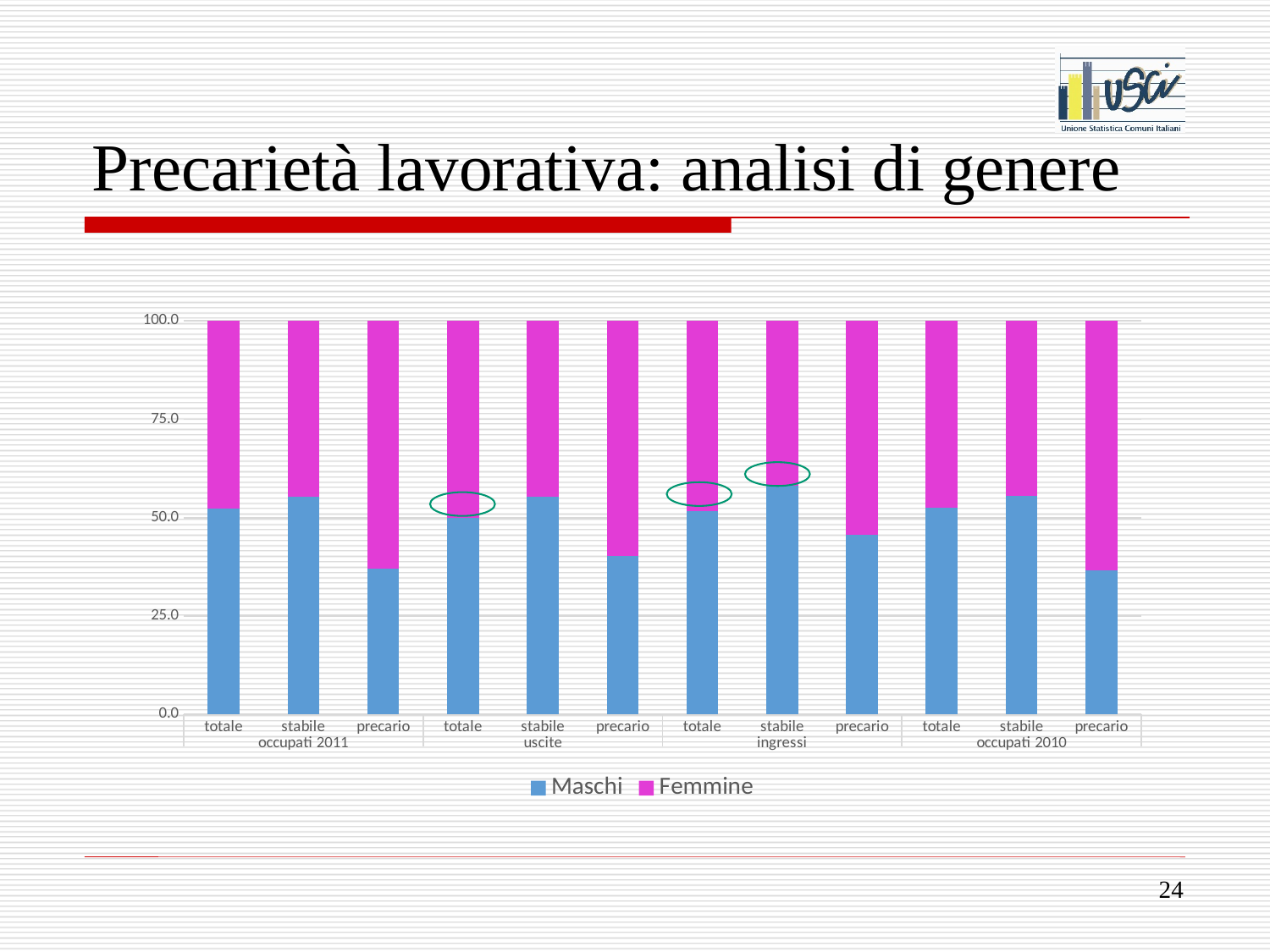
What kind of chart is shown on the slide? Stacked bar chart Is the Maschi value for precario in occupati 2011 greater or less than 50.0? less How many bars are plotted in the chart? 12 What colour represents the Femmine series? Magenta Is the Femmine value for precario in occupati 2010 greater or less than 50.0? greater Is the Maschi value for stabile in ingressi greater or less than 50.0? greater How many series does the legend list? 2 Which two series are listed in the legend? Maschi and Femmine How many groups of categories are shown along the x axis? 4 Within ingressi, which has the larger Femmine share: stabile or precario? precario What is the total height of each stacked bar? 100.0 Within occupati 2011, which has the larger Maschi share: stabile or precario? stabile